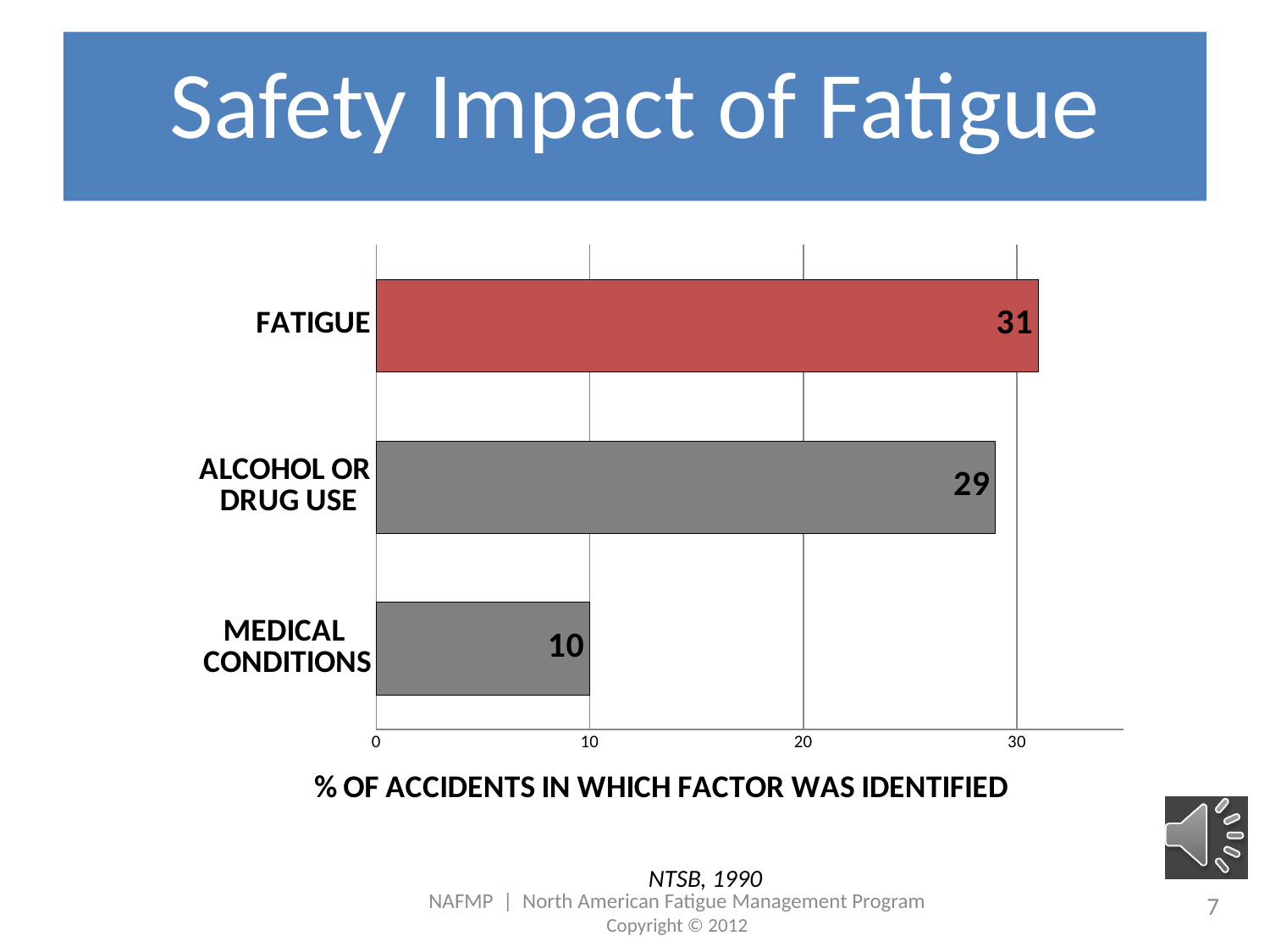
What is the difference between the values for FATIGUE and MEDICAL CONDITIONS? 21 What is the label of the horizontal axis? % OF ACCIDENTS IN WHICH FACTOR WAS IDENTIFIED What kind of chart is shown on the slide? bar chart Which category has the lowest value? MEDICAL CONDITIONS What is the value for ALCOHOL OR DRUG USE? 29 How many categories are shown in the chart? 3 Which category has the highest value? FATIGUE Which is larger, the value for ALCOHOL OR DRUG USE or the value for MEDICAL CONDITIONS? ALCOHOL OR DRUG USE What is the value for MEDICAL CONDITIONS? 10 What is the value for FATIGUE? 31 Is the value for ALCOHOL OR DRUG USE greater or less than 20? greater What is the difference between the values for FATIGUE and ALCOHOL OR DRUG USE? 2